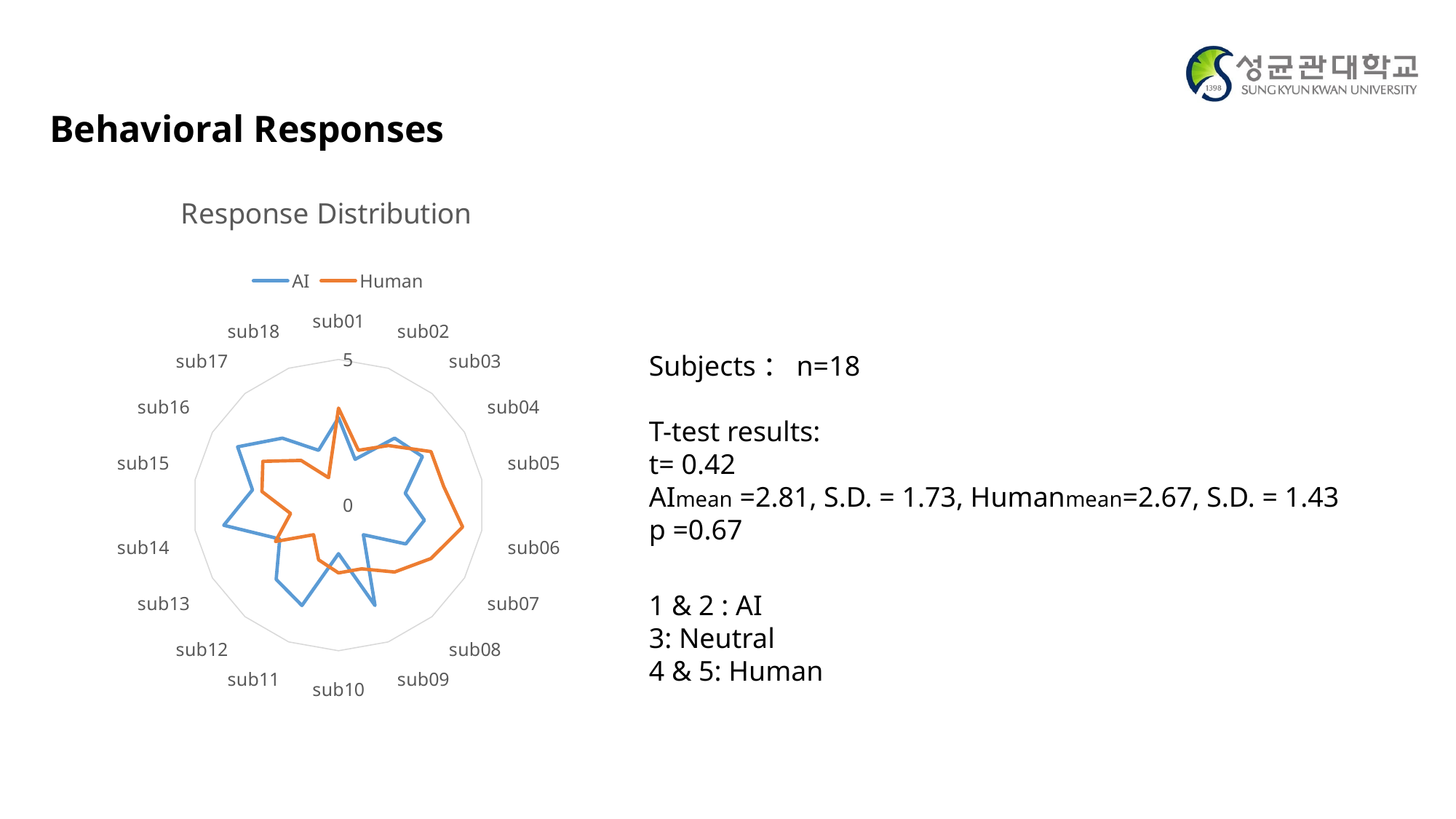
For sub14, which series has the larger value, AI or Human? AI How many series does the chart's legend list? 2 Which series is drawn in orange in the chart? Human How many subjects (categories) are plotted around the radar chart? 18 What kind of chart is shown on the slide? Radar chart Is the Human value for sub06 greater or less than 5? less For sub10, which series has the larger value, AI or Human? Human For sub12, which series has the larger value, AI or Human? AI What is the title of the chart? Response Distribution